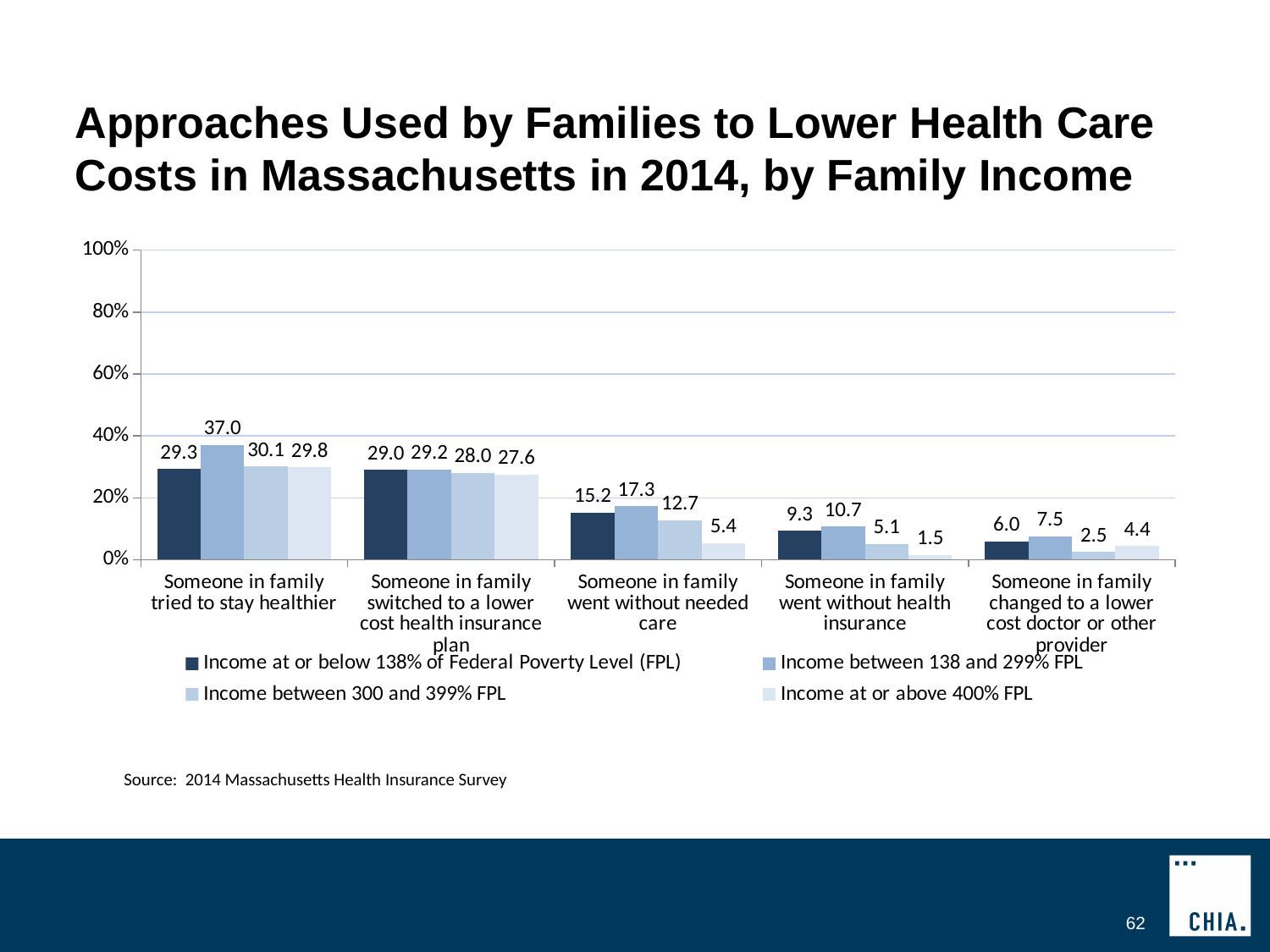
What is the value for "Income at or above 400% FPL" in the category "Someone in family went without needed care"? 5.4 Which income group has the highest value in the category "Someone in family tried to stay healthier"? Income between 138 and 299% FPL What is the value for "Income at or below 138% of Federal Poverty Level (FPL)" in the category "Someone in family went without health insurance"? 9.3 In the category "Someone in family changed to a lower cost doctor or other provider", which is larger: the value for "Income between 300 and 399% FPL" or the value for "Income at or above 400% FPL"? Income at or above 400% FPL What is the source cited below the chart? 2014 Massachusetts Health Insurance Survey What is the difference between the "Income between 138 and 299% FPL" value and the "Income at or above 400% FPL" value in the category "Someone in family went without needed care"? 11.9 Is the value for "Income between 138 and 299% FPL" in the category "Someone in family switched to a lower cost health insurance plan" greater or less than 40%? less What kind of chart is shown on the slide? bar chart How many categories of approaches are shown on the x axis? 5 How many income groups does the legend list? 4 Which income group has the lowest value in the category "Someone in family went without health insurance"? Income at or above 400% FPL What is the value for "Income between 138 and 299% FPL" in the category "Someone in family tried to stay healthier"? 37.0